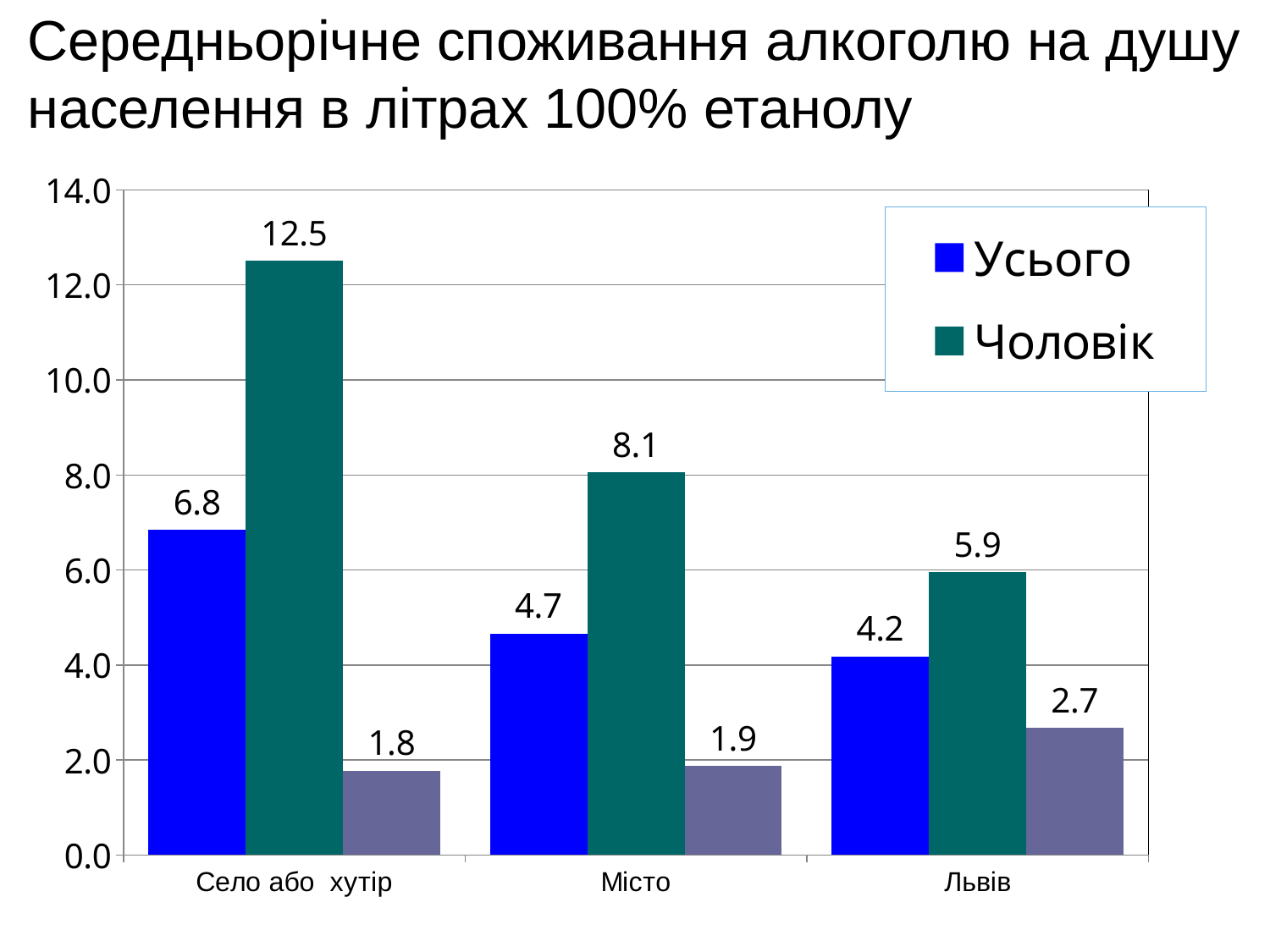
Which is larger, the Усього value for Місто or for Львів? Місто How many categories are shown on the x axis? 3 Is the value for Усього in Село або хутір greater or less than 6.0? greater How many series does the legend list? 2 What is the value for Усього in the Львів category? 4.2 What is the value for Усього in the Місто category? 4.7 Which category has the highest value for Чоловік? Село або хутір What kind of chart is shown on the slide? bar chart What is the value for Чоловік in the Львів category? 5.9 What is the value for Чоловік in the Село або хутір category? 12.5 Which category has the lowest value for Усього? Львів What is the difference between the Чоловік and Усього values for Село або хутір? 5.7